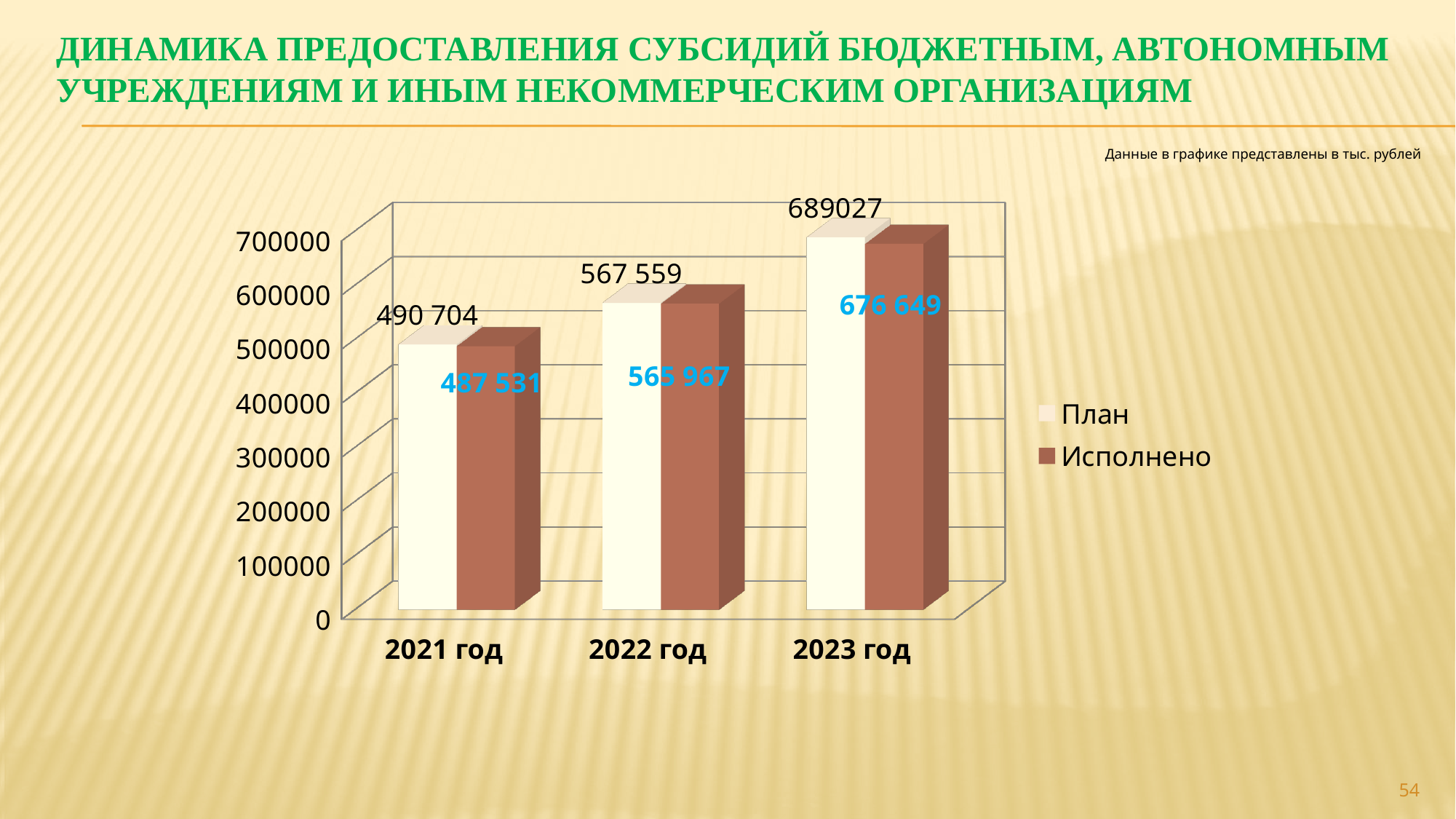
What is the difference between План and Исполнено for 2023 год? 12 378 How many series does the legend list? 2 Which year has the highest План value? 2023 год Which year has the lowest Исполнено value? 2021 год How many years are shown on the x axis? 3 What is the Исполнено value for 2022 год? 565 967 What is the Исполнено value for 2023 год? 676 649 Do the Исполнено values rise or fall from 2021 год to 2023 год? rise What is the План value for 2023 год? 689027 What is the План value for 2021 год? 490 704 Which is larger for 2022 год: План or Исполнено? План What is the difference between the План values for 2023 год and 2021 год? 198 323